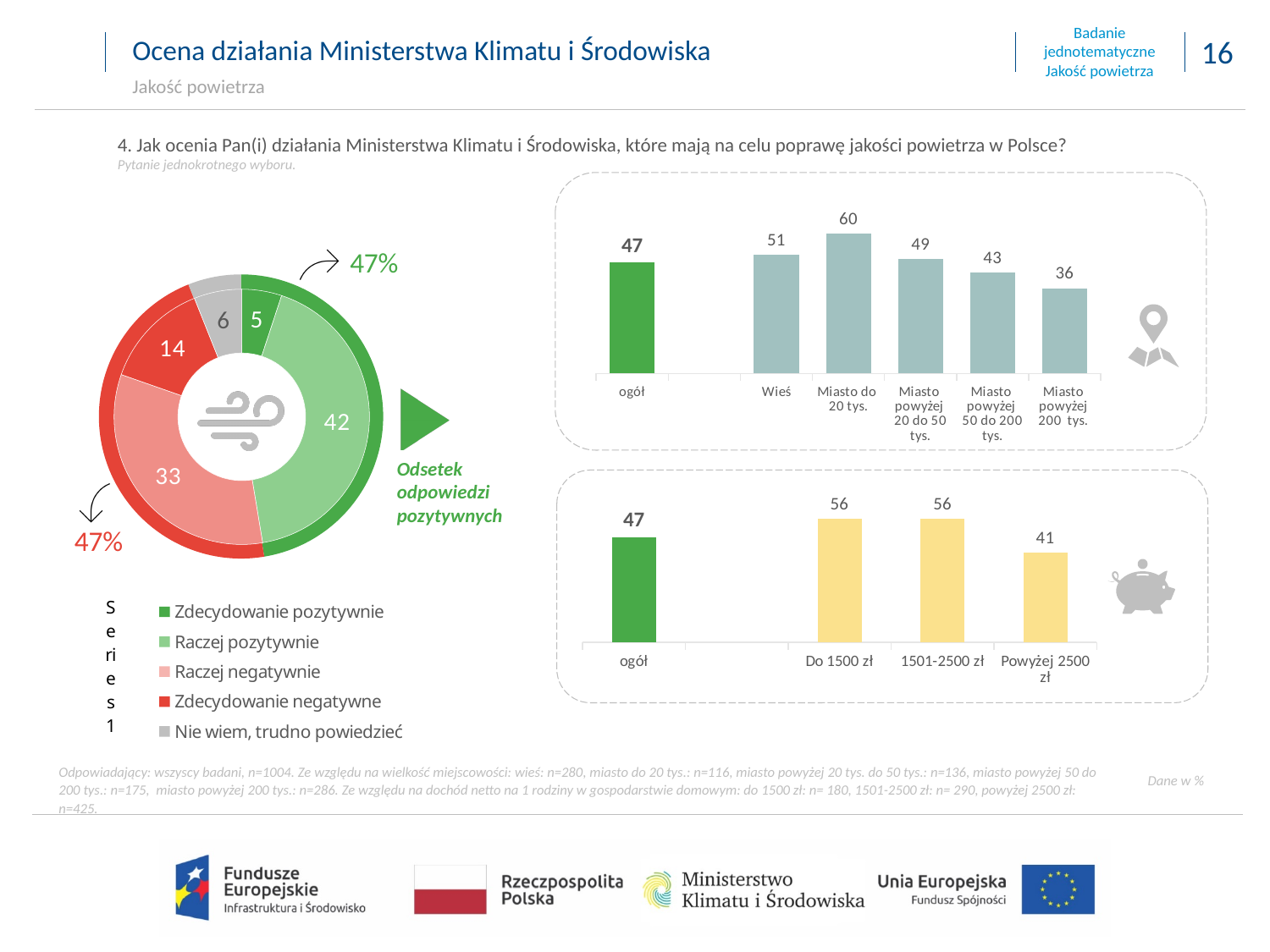
In the bottom-right bar chart (by income), what is the value for Powyżej 2500 zł? 41 In the top-right bar chart (by place of residence), which category has the highest value? Miasto do 20 tys. In the bottom-right bar chart (by income), what is the difference between the value for 1501-2500 zł and the value for ogół? 9 In the bottom-right bar chart (by income), which is larger: the value for Do 1500 zł or the value for Powyżej 2500 zł? Do 1500 zł What kind of chart is the chart on the left side of the slide? Donut (pie) chart In the top-right bar chart (by place of residence), what is the difference between the values for Miasto do 20 tys. and Miasto powyżej 200 tys.? 24 In the top-right bar chart (by place of residence), which category has the lowest value? Miasto powyżej 200 tys. How many entries does the legend of the donut chart on the left list? 5 In the top-right bar chart (by place of residence), what is the value for Wieś? 51 In the donut chart on the left, which category has the smallest value? Zdecydowanie pozytywnie In the top-right bar chart (by place of residence), how many bars are plotted? 6 In the donut chart on the left, what is the value for Raczej pozytywnie? 42